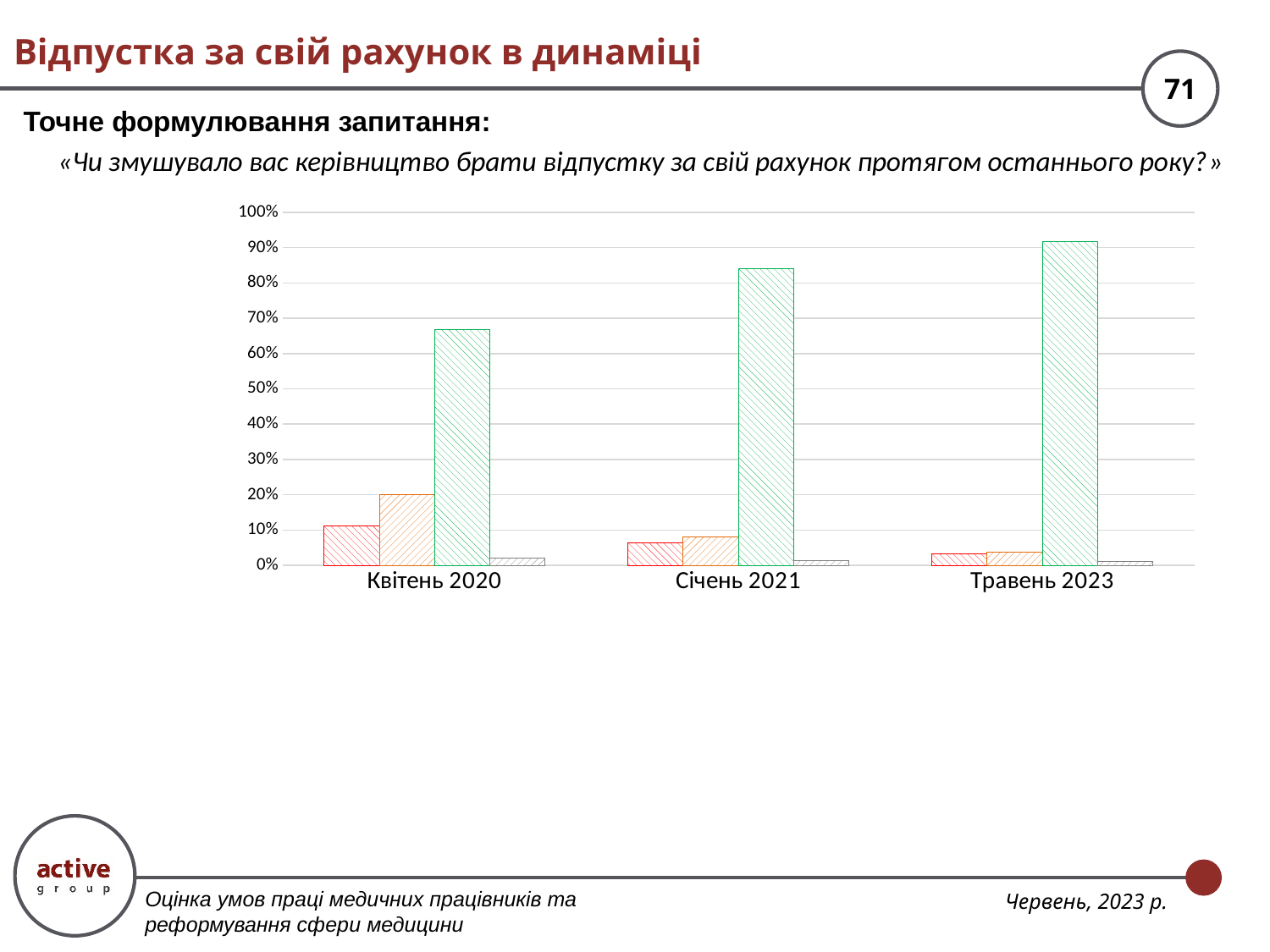
How many categories (time periods) are shown on the x axis of the chart? 3 Which is larger: the tallest (green hatched) bar for Квітень 2020 or the tallest bar for Січень 2021? Січень 2021 Which category has the tallest bar in the chart? Травень 2023 What is the highest value shown on the vertical axis of the chart? 100% What kind of chart is shown on the slide? bar chart Is the tallest (green hatched) bar for Травень 2023 greater or less than 80%? greater Is the tallest (green hatched) bar for Квітень 2020 greater or less than 60%? greater Is the tallest (green hatched) bar for Квітень 2020 greater or less than 70%? less How many bars are plotted for each category in the chart? 4 Do the tallest (green hatched) bars rise or fall from Квітень 2020 to Травень 2023? rise